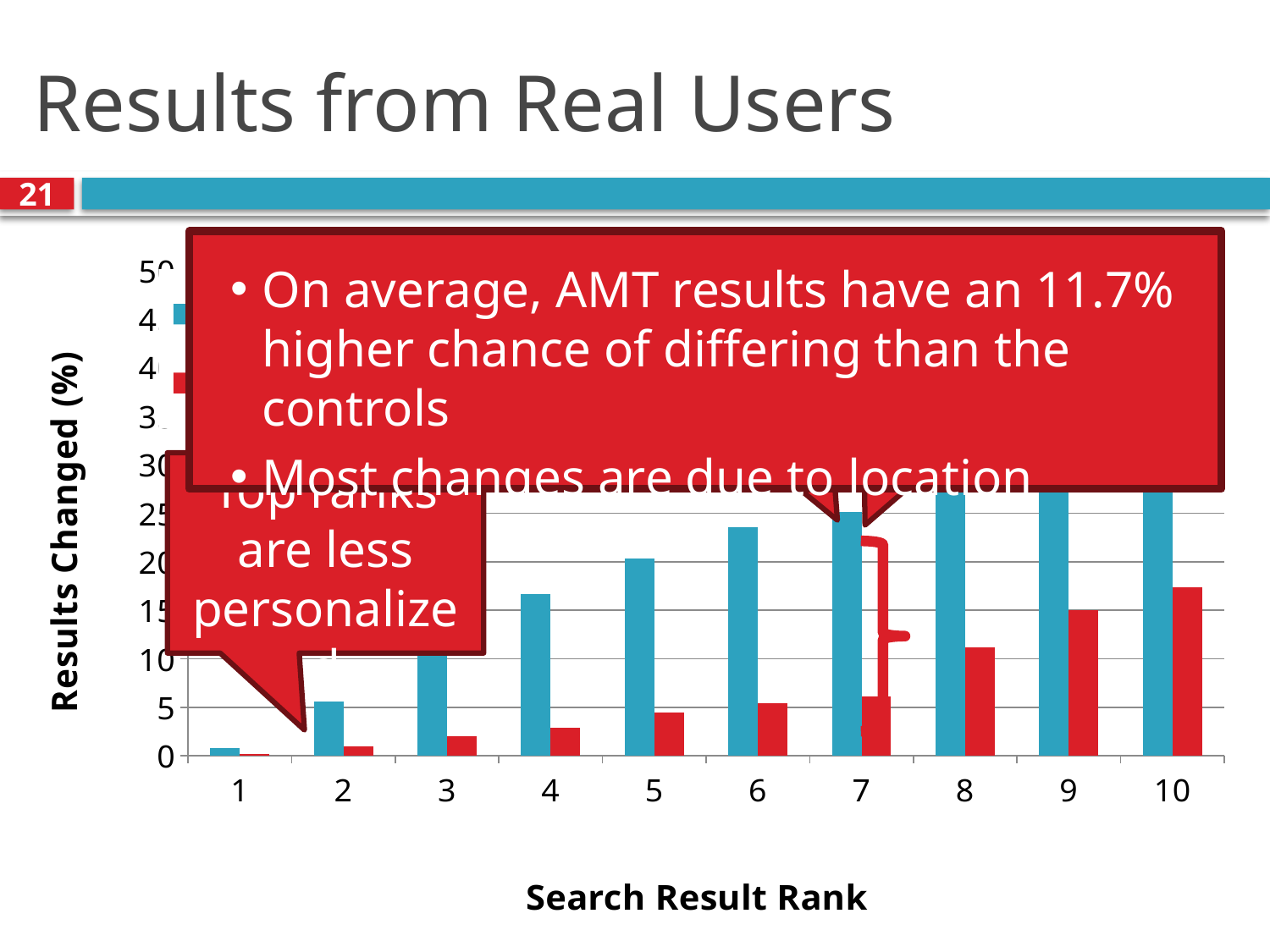
What is the title of the x axis of the chart? Search Result Rank Is the value of the blue bar for rank 6 greater or less than 20? greater Is the value of the blue bar for rank 2 greater or less than 10? less How many search result ranks are shown on the x axis of the chart? 10 For the red bars, which rank has the highest value? 10 Is the value of the red bar for rank 9 greater or less than 10? greater What kind of chart is shown on the slide? bar chart For the red bars, which rank has the lowest value? 1 What is the title of the y axis of the chart? Results Changed (%) At rank 6, which bar is larger, the blue bar or the red bar? the blue bar Do the red bars rise or fall as the search result rank increases from 1 to 10? rise